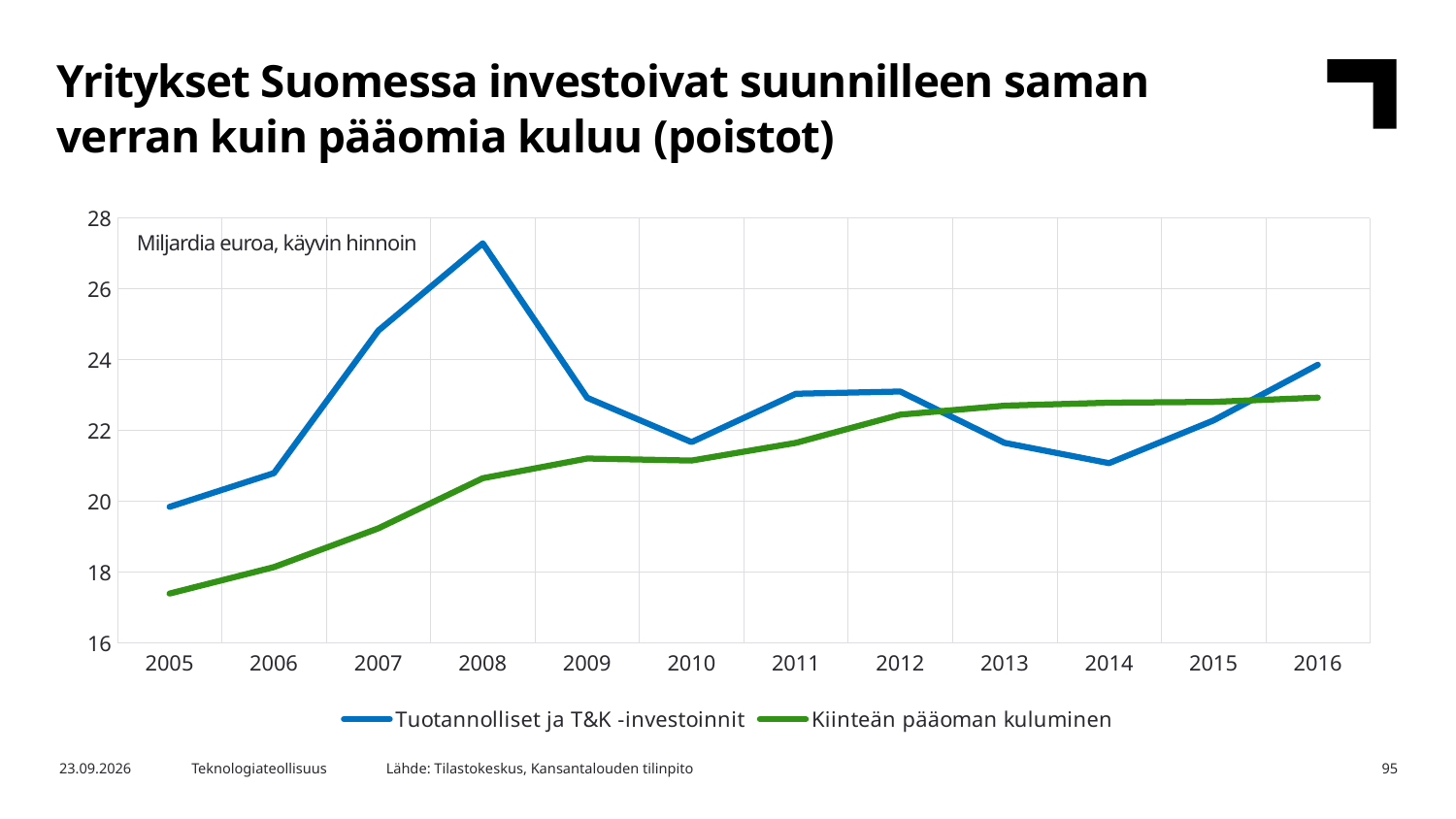
Is the value for Kiinteän pääoman kuluminen in 2005 greater or less than 18? less What kind of chart is shown on the slide? line chart In 2014, which series has the higher value: Tuotannolliset ja T&K -investoinnit or Kiinteän pääoman kuluminen? Kiinteän pääoman kuluminen In which year is the Kiinteän pääoman kuluminen line at its lowest? 2005 Is the value for Tuotannolliset ja T&K -investoinnit in 2008 greater or less than 26? greater In which year is the Tuotannolliset ja T&K -investoinnit line at its lowest? 2005 Does the Kiinteän pääoman kuluminen line generally rise or fall from 2005 to 2016? rise How many years are shown on the x axis? 12 In which year does the Tuotannolliset ja T&K -investoinnit line reach its highest value? 2008 Is the value for Tuotannolliset ja T&K -investoinnit in 2014 greater or less than 22? less How many series does the legend list? 2 In 2008, which series has the higher value: Tuotannolliset ja T&K -investoinnit or Kiinteän pääoman kuluminen? Tuotannolliset ja T&K -investoinnit